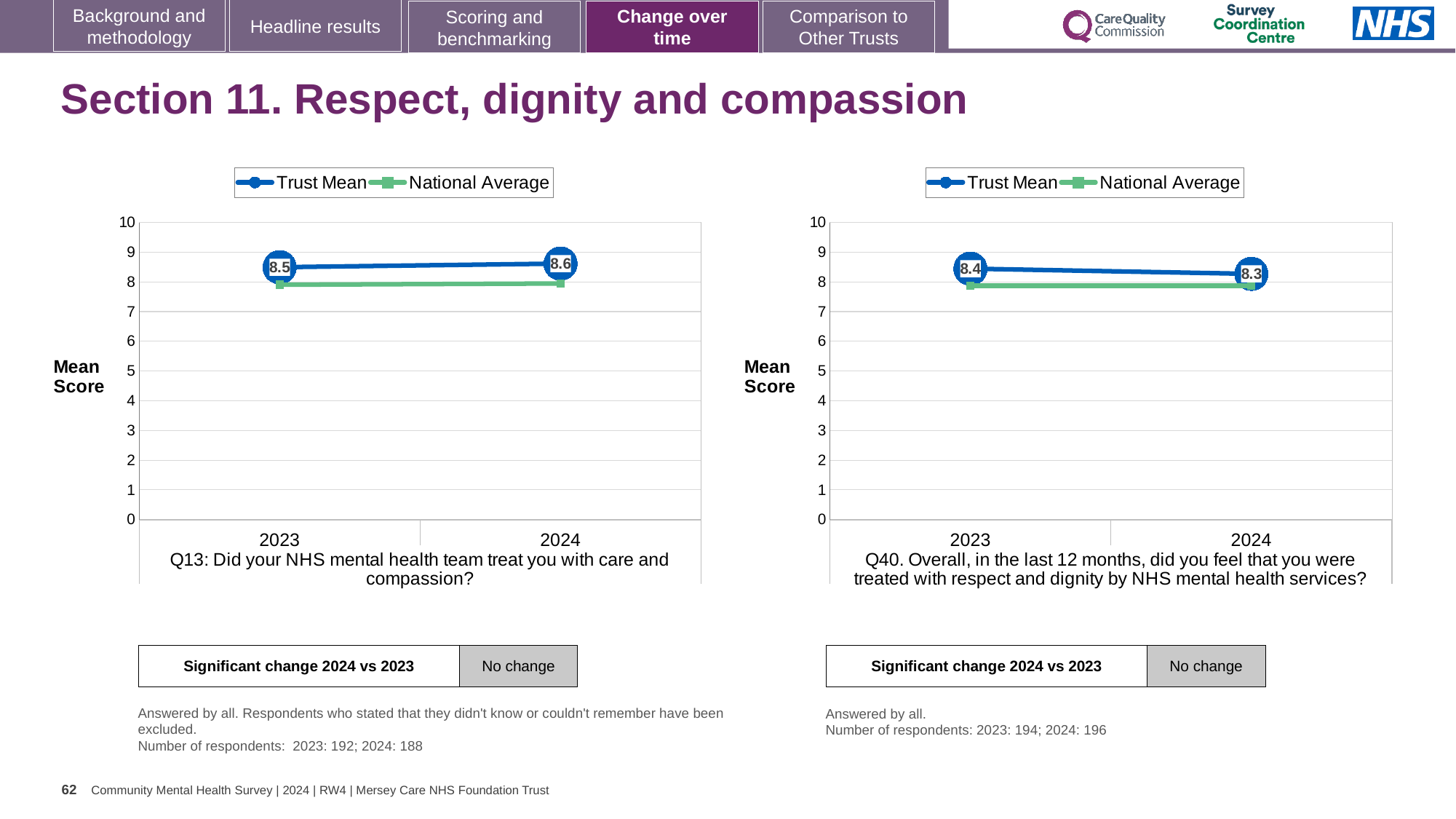
In the left chart (Q13), by how much did the Trust Mean change from 2023 to 2024? 0.1 What are the two series named in the legend of the right chart? Trust Mean and National Average In the right chart (Q40), what is the Trust Mean for 2023? 8.4 How many series does the legend of the left chart list? 2 In the right chart (Q40), which year has the higher Trust Mean, 2023 or 2024? 2023 In the left chart (Q13), what is the Trust Mean for 2024? 8.6 What kind of chart is used on this slide? line chart In the right chart (Q40), does the Trust Mean rise or fall from 2023 to 2024? fall In the right chart (Q40), is the National Average for 2024 greater or less than 5? greater In the left chart (Q13), what is the Trust Mean for 2023? 8.5 In the left chart (Q13), does the Trust Mean rise or fall from 2023 to 2024? rise In the right chart (Q40), what is the Trust Mean for 2024? 8.3